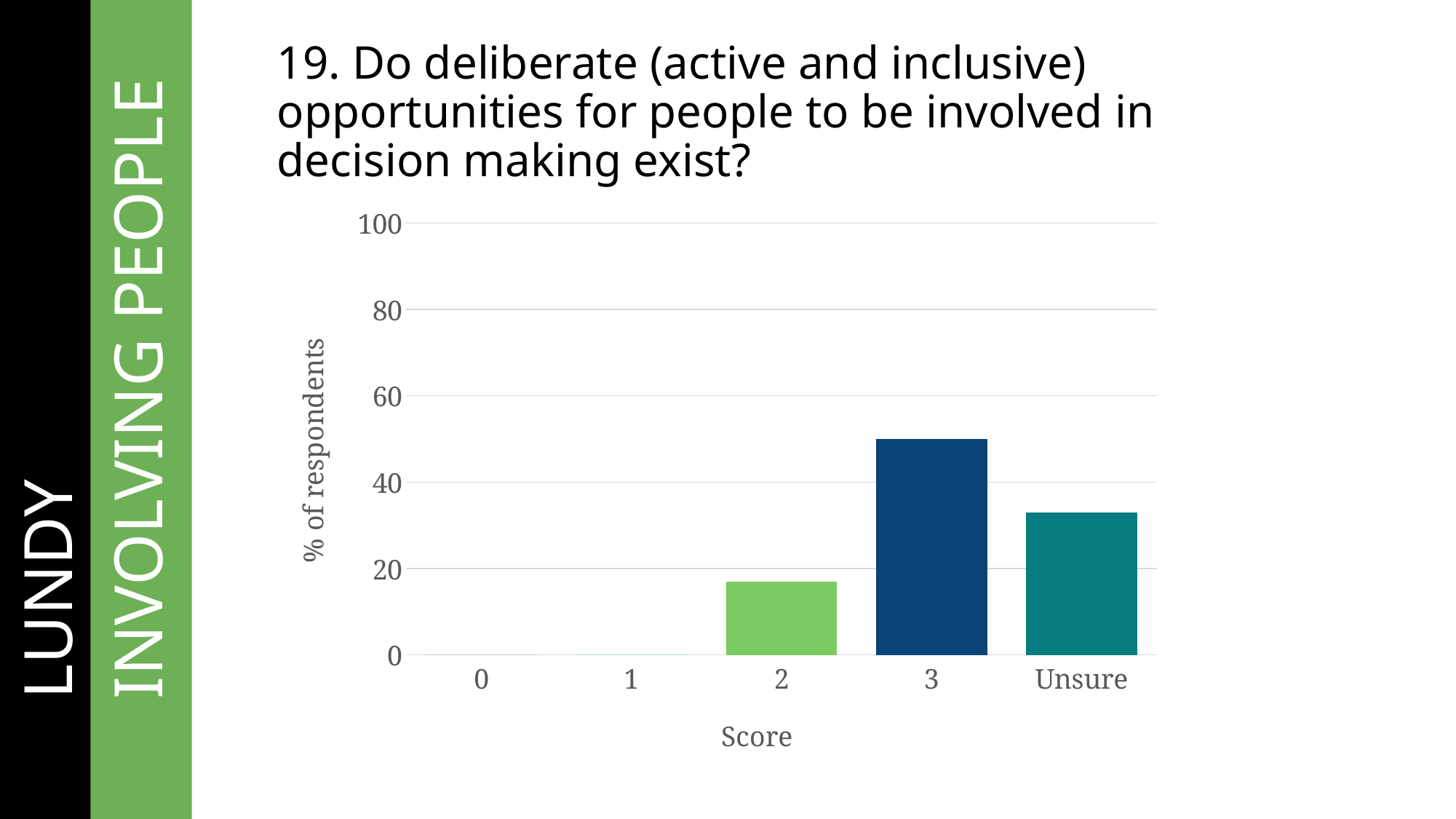
Which is larger, the value for score 2 or the value for Unsure? Unsure Which is larger, the value for score 3 or the value for Unsure? 3 Is the value for Unsure greater or less than 40? less Do the values rise or fall as the score increases from 0 to 3? rise How many categories are shown on the x axis of the chart? 5 Which score category has the highest percentage of respondents? 3 Is the value for score 3 greater or less than 40? greater Is the value for score 2 greater or less than 20? less What kind of chart is shown on the slide? bar chart What is the label on the y axis of the chart? % of respondents